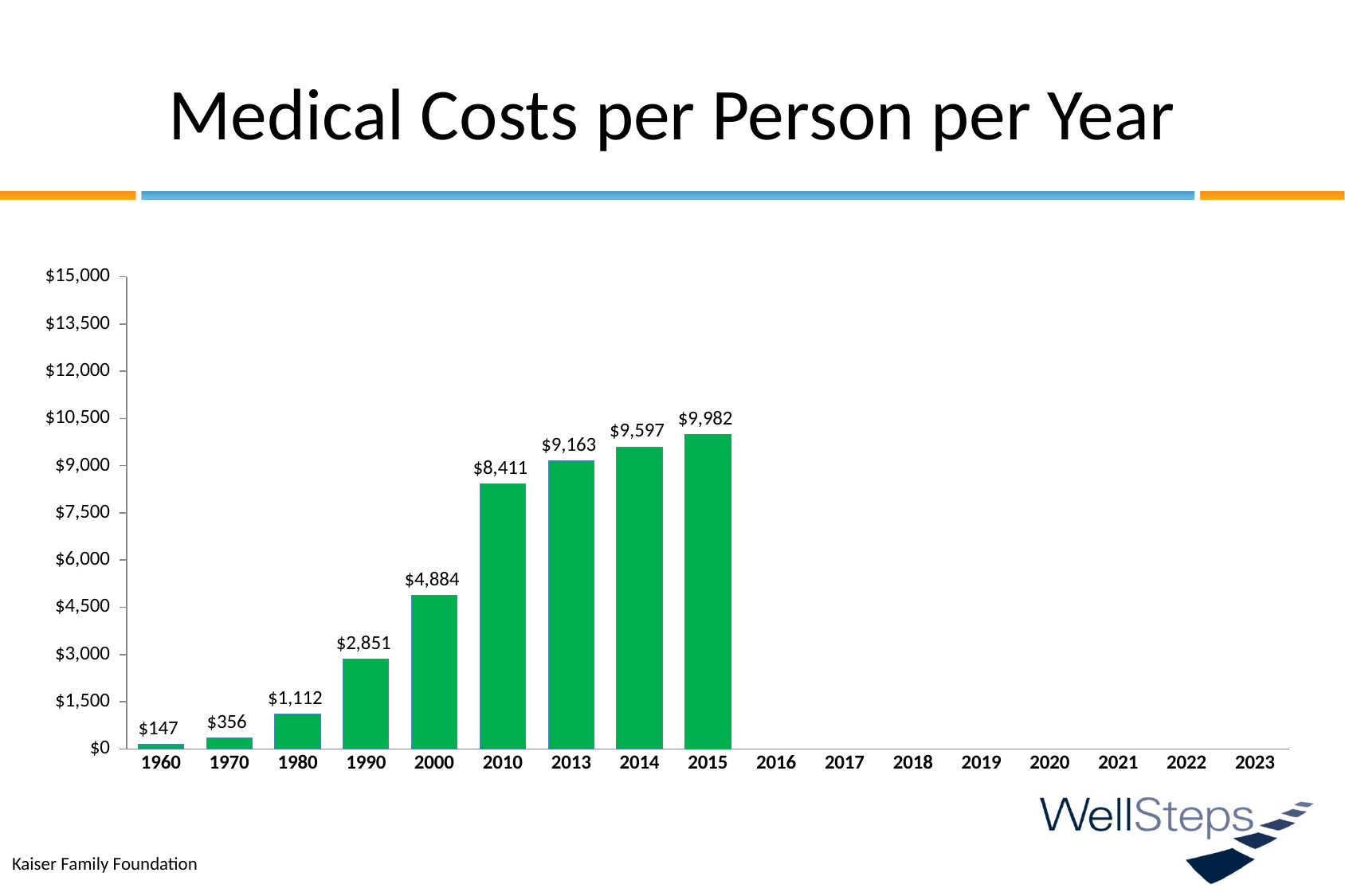
What is the medical cost per person per year shown for 2015? $9,982 What kind of chart is shown on the slide? bar chart Is the value for 2014 greater or less than $9,000? greater Which year has the lowest medical cost per person? 1960 Do the values rise or fall from 1960 to 2015? rise What is the difference between the values for 2010 and 2000? $3,527 What is the difference between the values for 2015 and 2014? $385 Which year has the highest medical cost per person? 2015 What is the value shown for 2000? $4,884 What is the value shown for 1990? $2,851 How many bars are plotted with values on the chart? 9 Which is larger, the value for 2013 or the value for 2010? 2013